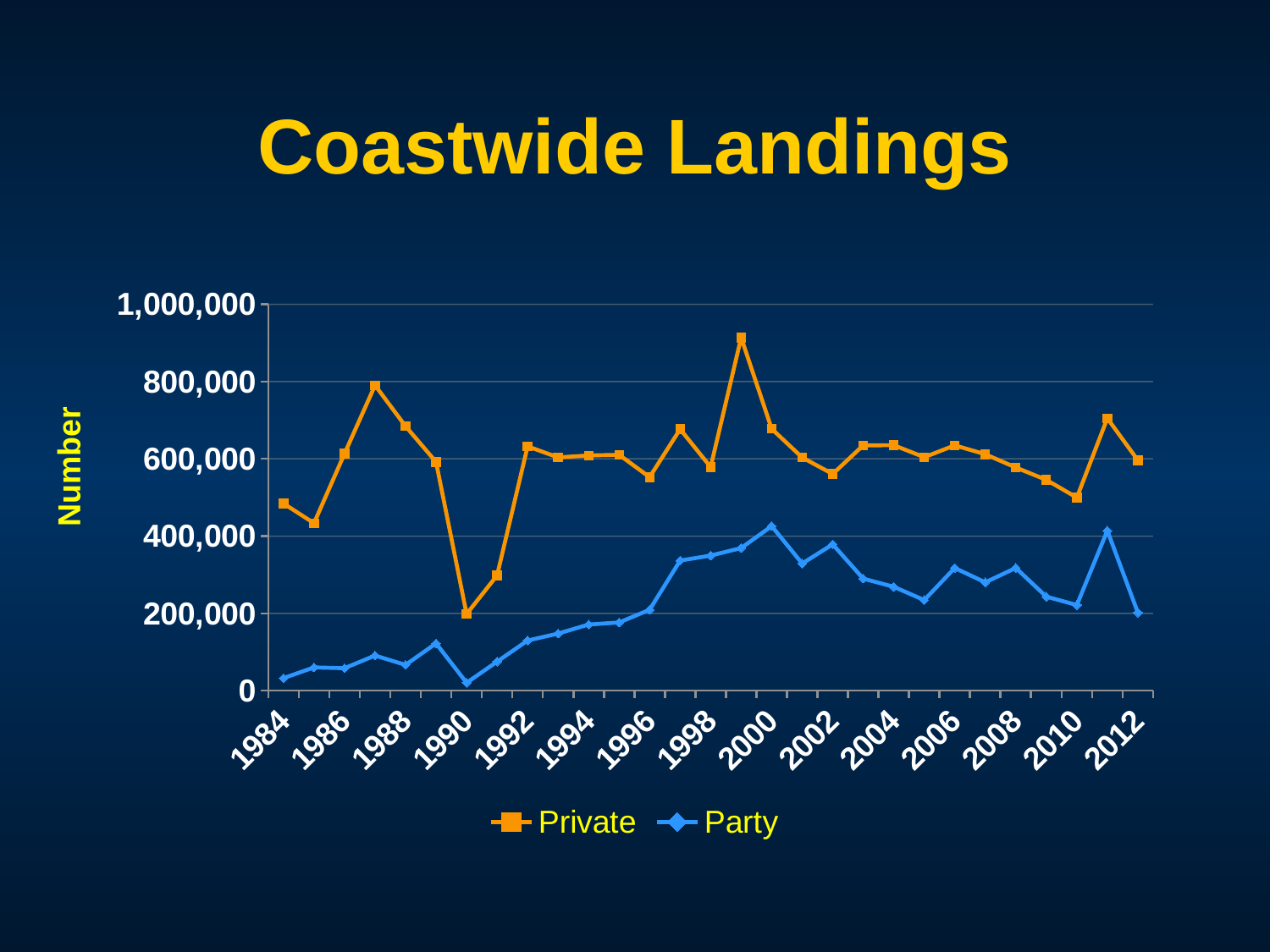
In which year does the Private series reach its highest value? 1999 How many series does the legend list? 2 Which series has the larger value in 2000, Private or Party? Private What is the label on the vertical axis? Number How many years are labelled on the x axis? 15 Does the Party series generally rise or fall between 1990 and 2000? rise Is the value for Party in 1990 greater or less than 200,000? less Is the value for Private in 1999 greater or less than 800,000? greater What is the title of the chart? Coastwide Landings What kind of chart is shown on the slide? line chart Is the value for Private in 2011 greater or less than 600,000? greater In which year does the Private series reach its lowest value? 1990